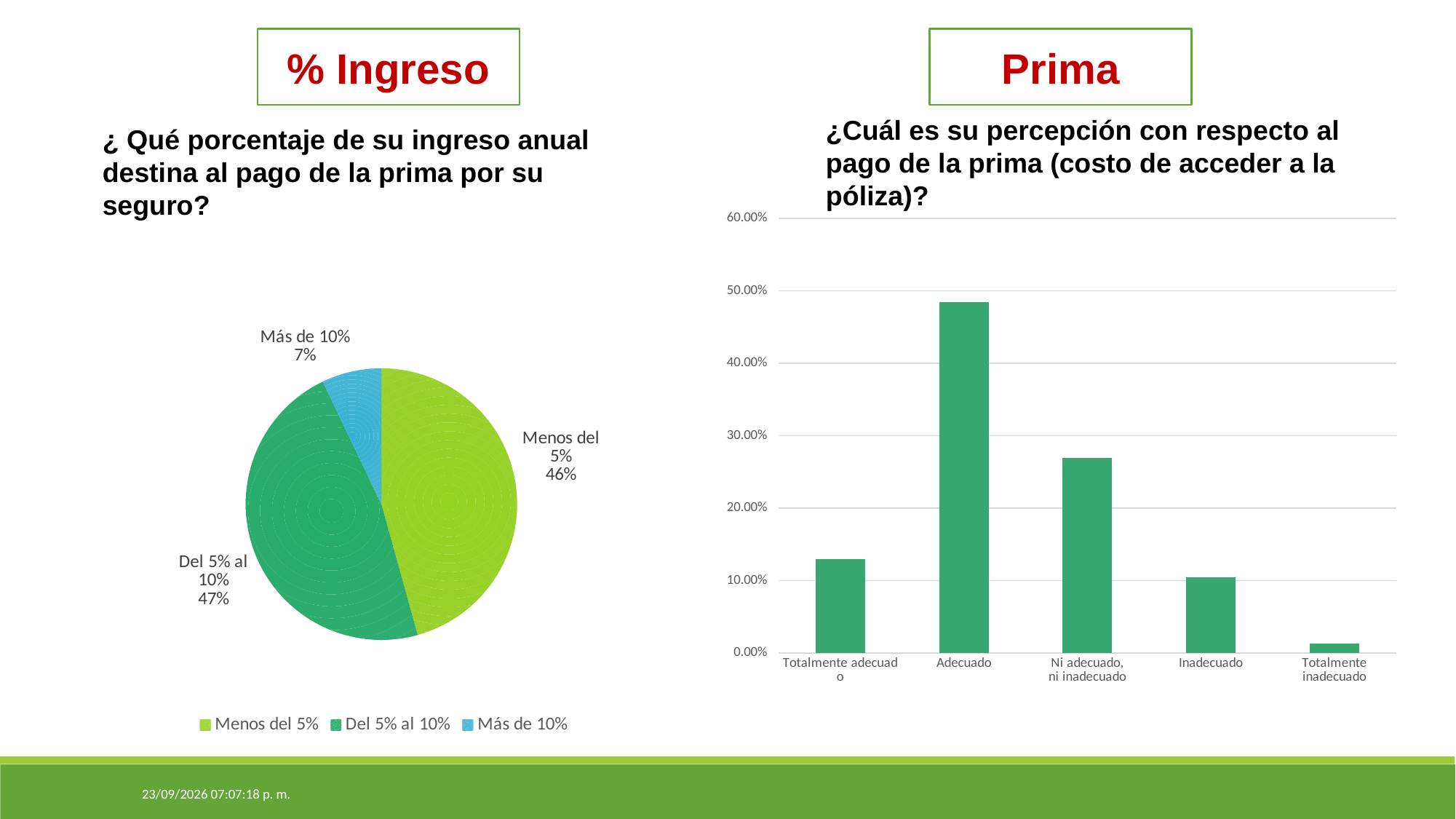
In the pie chart on the left (% Ingreso), which category has the largest share according to the printed labels? Del 5% al 10% In the pie chart on the left (% Ingreso), what share is labelled for 'Del 5% al 10%'? 47% In the pie chart on the left (% Ingreso), which category has the smallest share? Más de 10% In the bar chart on the right (Prima), which category has the lowest value? Totalmente inadecuado In the pie chart on the left (% Ingreso), what share is labelled for 'Más de 10%'? 7% In the bar chart on the right (Prima), how many categories are shown on the x axis? 5 In the pie chart on the left (% Ingreso), what is the difference between the shares for 'Del 5% al 10%' and 'Más de 10%'? 40% What kind of chart is shown on the right under 'Prima'? Bar chart In the bar chart on the right (Prima), is the value for 'Ni adecuado, ni inadecuado' greater or less than 30.00%? less In the bar chart on the right (Prima), which category has the highest value? Adecuado In the pie chart on the left (% Ingreso), how many categories does the legend list? 3 In the pie chart on the left (% Ingreso), what share is labelled for 'Menos del 5%'? 46%